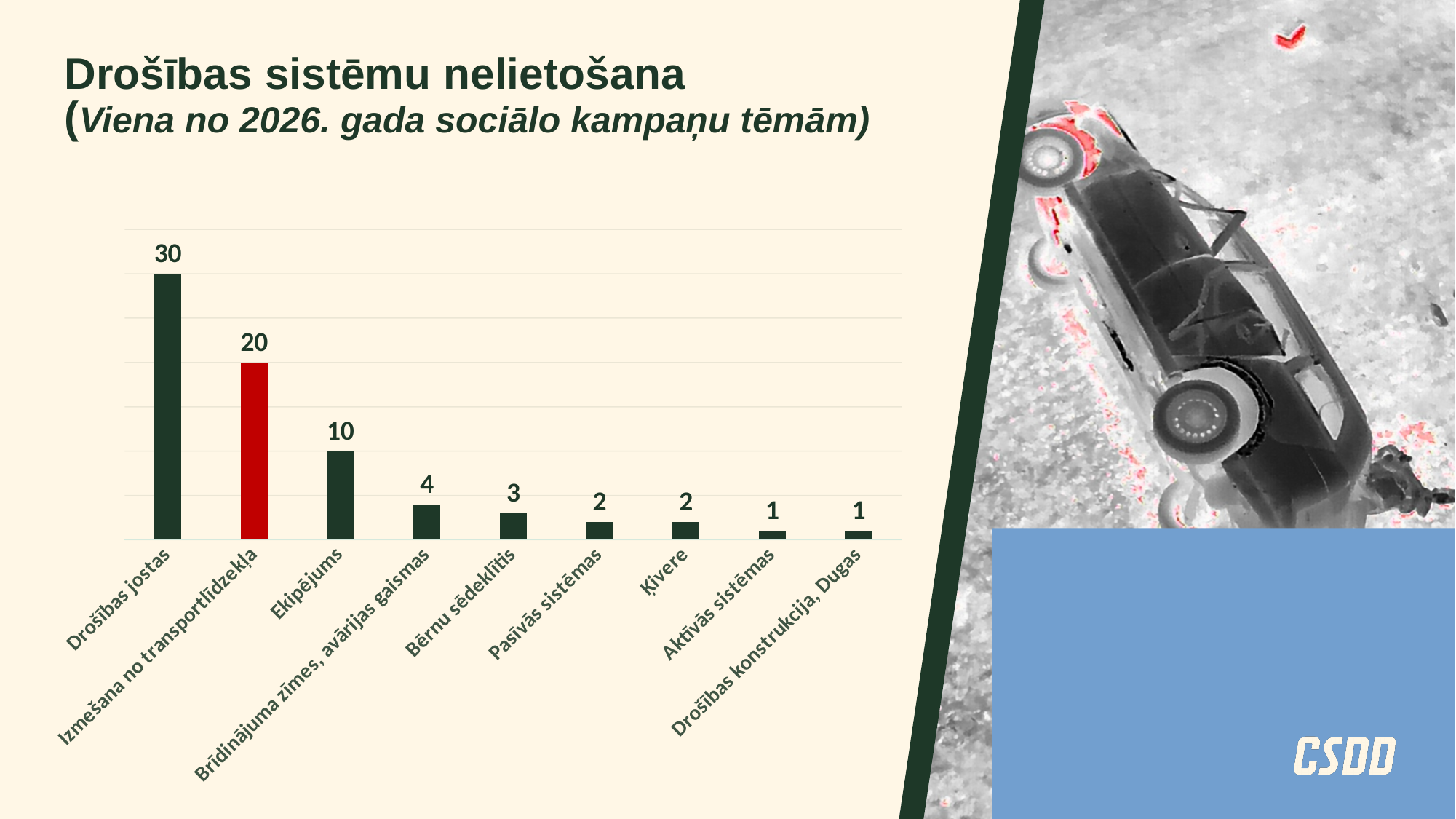
Which is larger, the value for Ekipējums or the value for Brīdinājuma zīmes, avārijas gaismas? Ekipējums What is the difference between the values for Drošības jostas and Izmešana no transportlīdzekļa? 10 What is the value for Bērnu sēdeklītis? 3 Which category has the highest value? Drošības jostas What is the value for Izmešana no transportlīdzekļa? 20 How many categories are shown in the chart? 9 Which bar is coloured red? Izmešana no transportlīdzekļa Do the values rise or fall from left to right along the x axis? Fall What is the value for Ķivere? 2 What is the value for Ekipējums? 10 What kind of chart is shown on the slide? Bar chart What is the value for Drošības jostas? 30